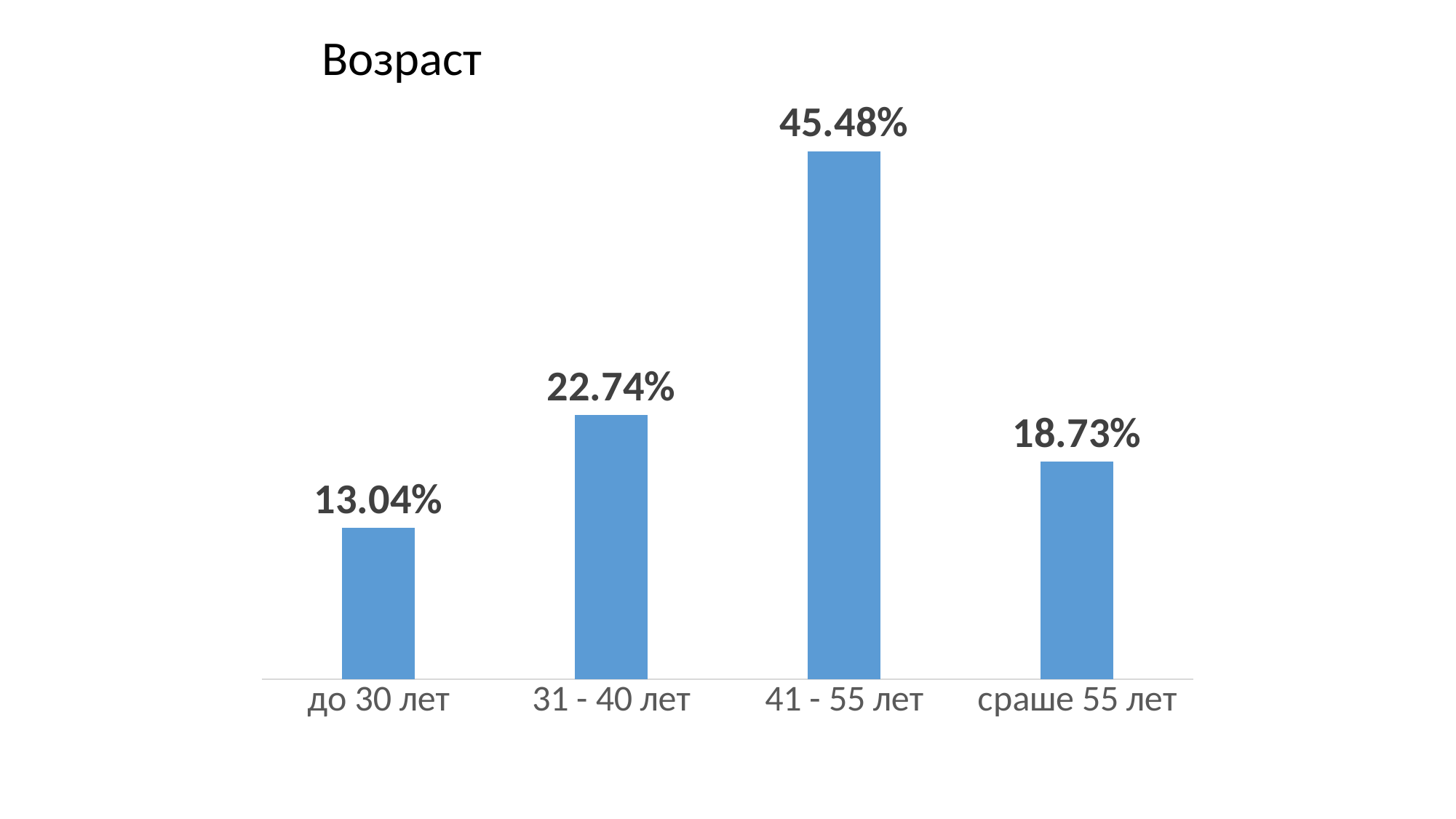
What is the difference between the values for "41 - 55 лет" and "31 - 40 лет"? 22.74% What is the value for the "до 30 лет" category? 13.04% What is the difference between the values for "сраше 55 лет" and "до 30 лет"? 5.69% What is the value for the "сраше 55 лет" category? 18.73% What is the value for the "41 - 55 лет" category? 45.48% What is the value for the "31 - 40 лет" category? 22.74% What kind of chart is shown on the slide? Bar chart Which category has the lowest value? до 30 лет What is the title of the chart? Возраст Which category has the highest value? 41 - 55 лет Which is larger, the value for "31 - 40 лет" or the value for "сраше 55 лет"? 31 - 40 лет How many categories are shown in the chart? 4